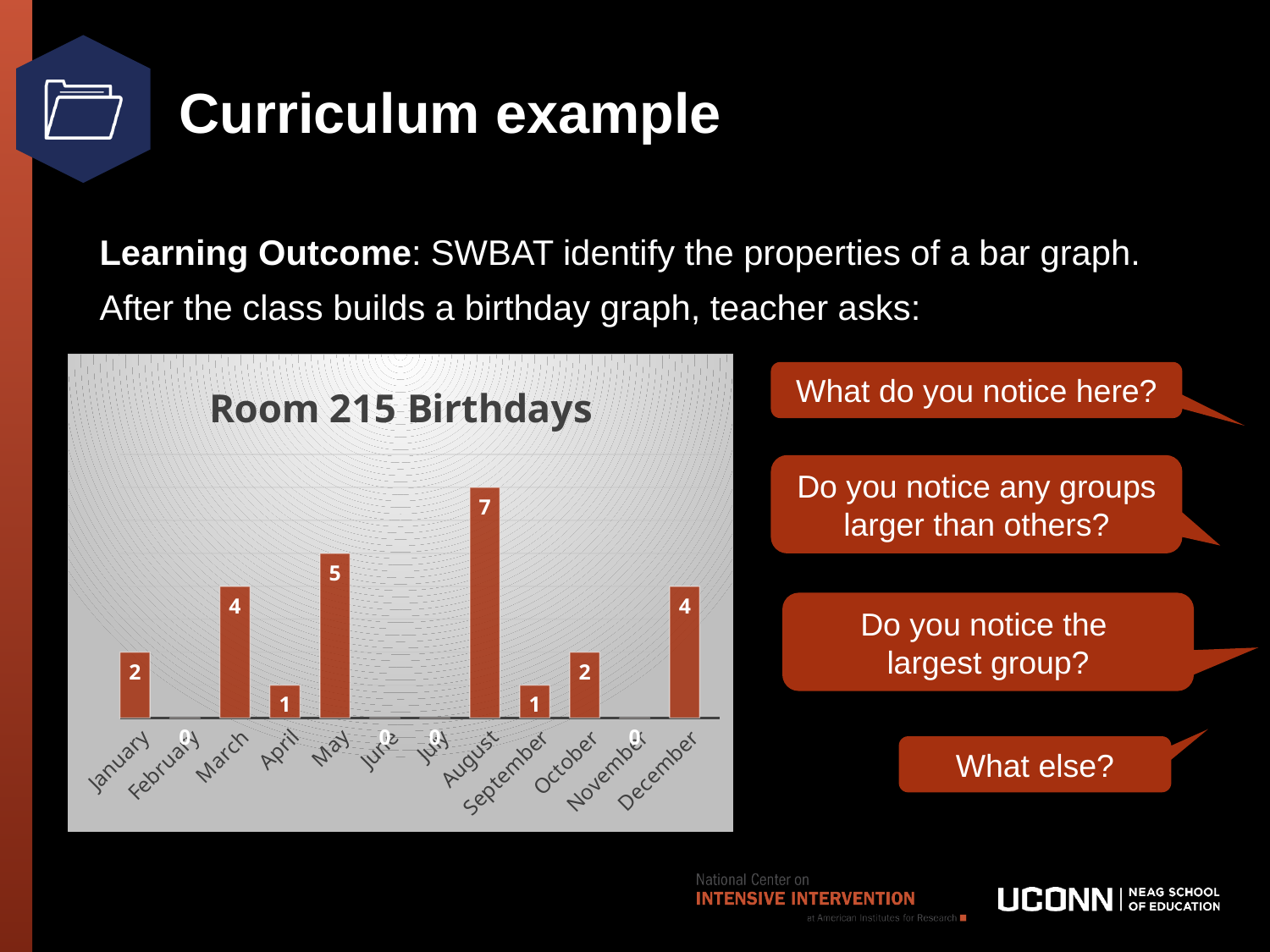
How many birthdays are shown for December? 4 What is the difference between the number of birthdays in August and in May? 2 What kind of chart is shown on the slide? bar chart How many birthdays are shown for August? 7 How many birthdays are shown for January? 2 Which has more birthdays, March or April? March What is the difference between the number of birthdays in March and in October? 2 How many birthdays are shown for September? 1 What is the title of the chart? Room 215 Birthdays How many months are shown on the x axis of the chart? 12 Which month has the most birthdays? August How many birthdays are shown for May? 5